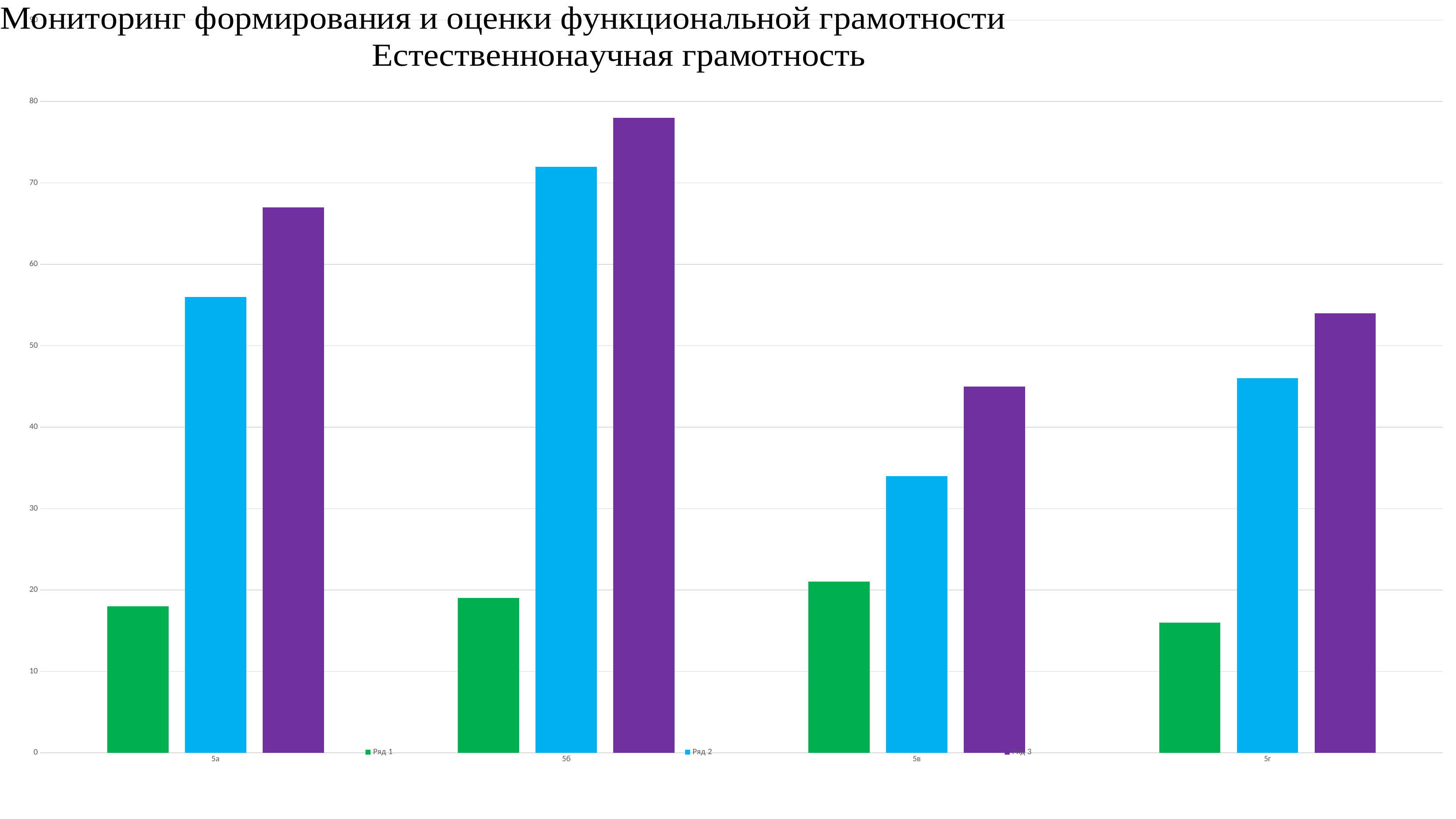
Which colour represents Ряд 1 in the legend? green Which is larger: the value of Ряд 2 for 5б or the value of Ряд 3 for 5а? Ряд 2 for 5б For which category is the value of Ряд 2 the highest? 5б For which category is the value of Ряд 2 the lowest? 5в For which category is the value of Ряд 3 the highest? 5б Is the value of Ряд 3 for 5б greater or less than 70? greater Is the value of Ряд 1 for 5г greater or less than 20? less How many categories are shown on the x axis? 4 What kind of chart is shown on the slide? bar chart Is the value of Ряд 2 for 5в greater or less than 40? less For which category is the value of Ряд 3 the lowest? 5в How many series does the legend list? 3